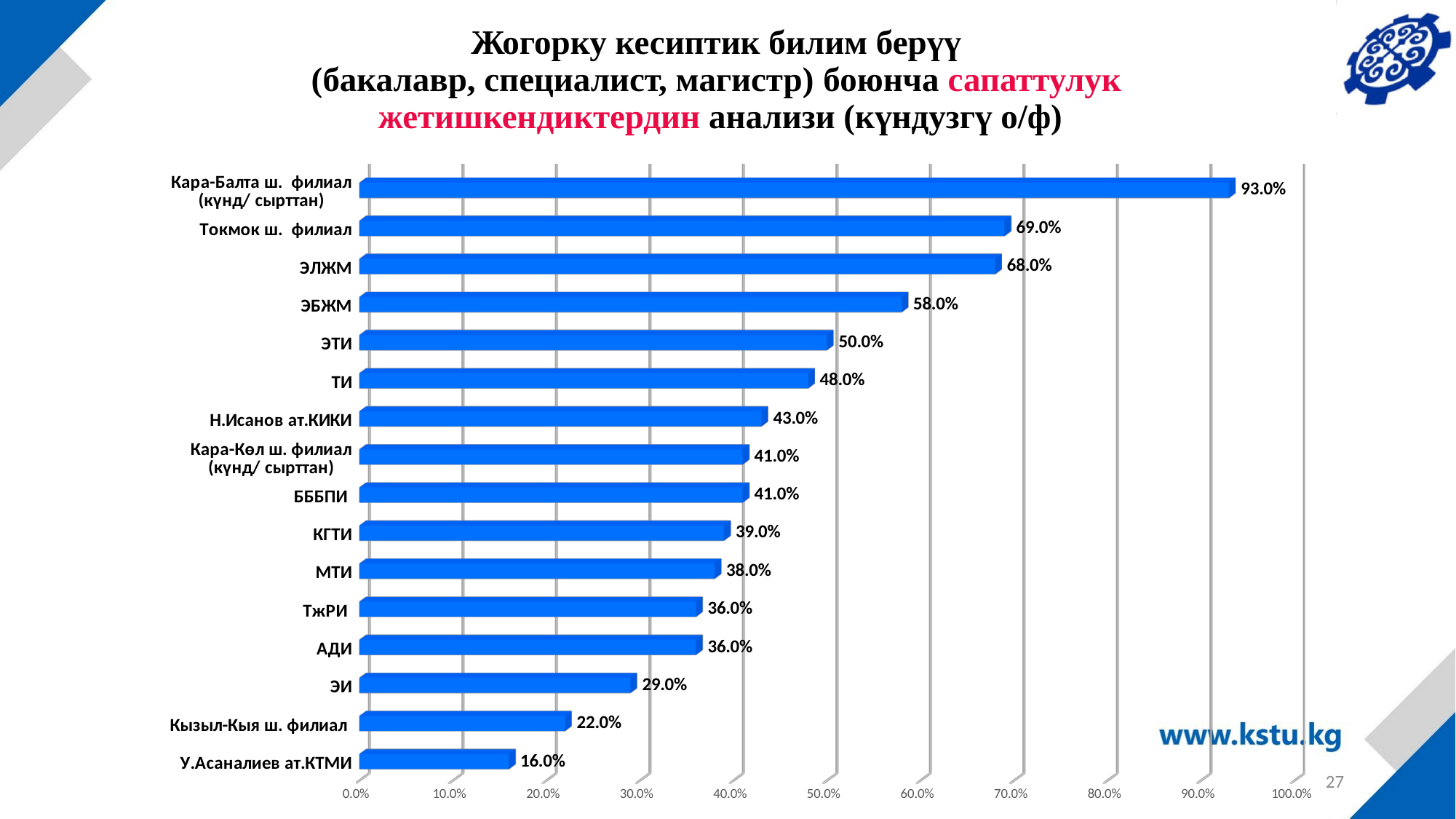
What is the value for Токмок ш. филиал? 69.0% What is the value for ЭТИ? 50.0% What kind of chart is shown on the slide? bar chart What is the difference between the values for ЭЛЖМ and ЭБЖМ? 10.0% Is the value for ЭИ greater or less than 30.0%? less Which category has the highest value? Кара-Балта ш. филиал (күнд/ сырттан) What is the difference between the values for Кара-Балта ш. филиал (күнд/ сырттан) and У.Асаналиев ат.КТМИ? 77.0% Which category has the lowest value? У.Асаналиев ат.КТМИ What is the value for Кызыл-Кыя ш. филиал? 22.0% How many categories are shown in the chart? 16 What colour are the bars in the chart? blue Which is larger, the value for ТИ or the value for Н.Исанов ат.КИКИ? ТИ